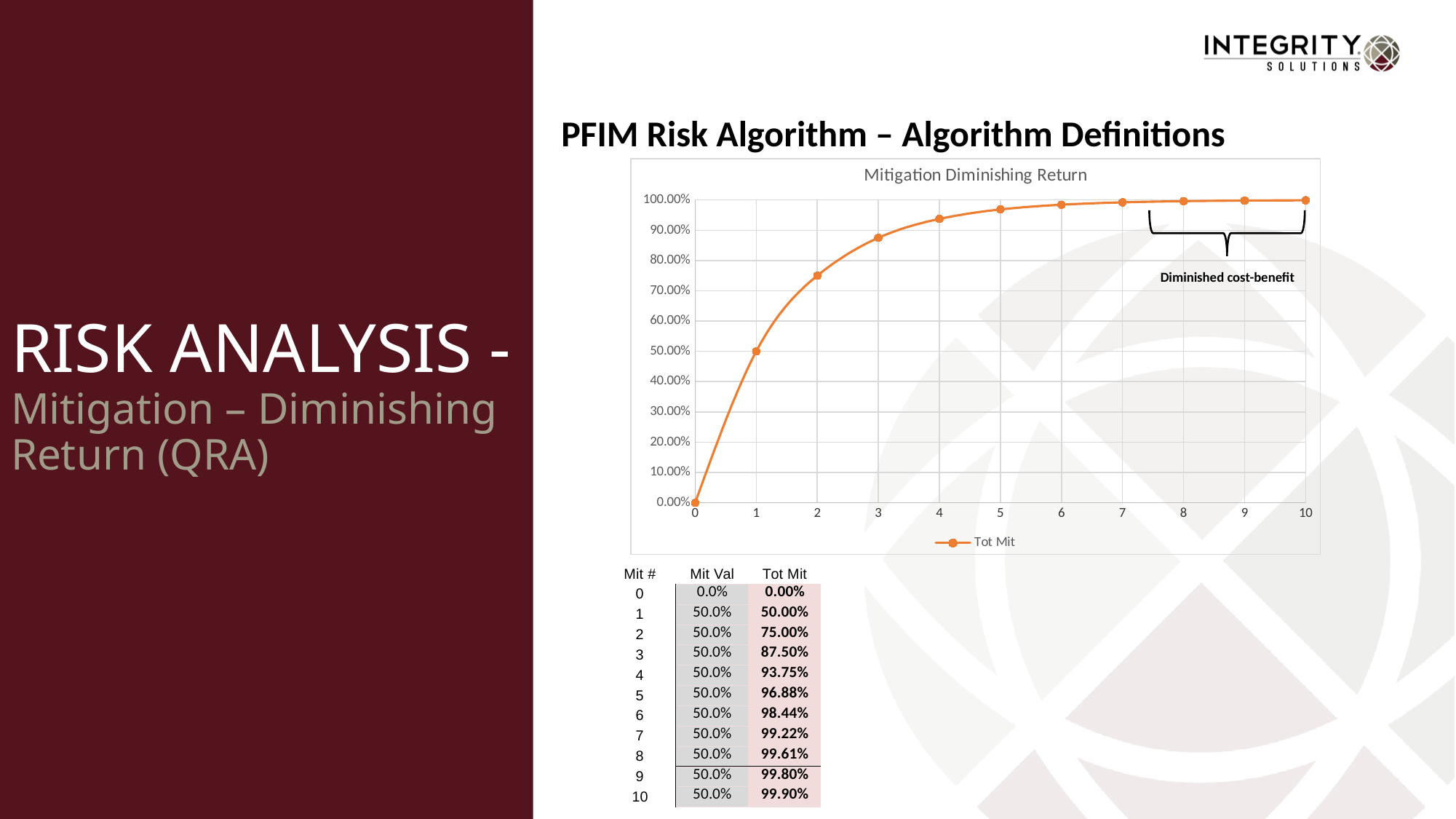
What is the difference between the Tot Mit value at x = 2 and at x = 1? 25.00% What is the title of the chart? Mitigation Diminishing Return What is the Tot Mit value at x = 1? 50.00% What type of chart is shown on the slide? Line chart Does the Tot Mit value rise or fall as x increases from 0 to 10? Rise Which is larger, the Tot Mit value at x = 1 or at x = 4? x = 4 How many series does the chart legend list? 1 What is the Tot Mit value at x = 3? 87.50% What is the name of the series plotted in the chart? Tot Mit Is the Tot Mit value at x = 2 greater or less than 70.00%? greater How many data points are plotted on the Tot Mit line? 11 What is the Tot Mit value at x = 0? 0.00%